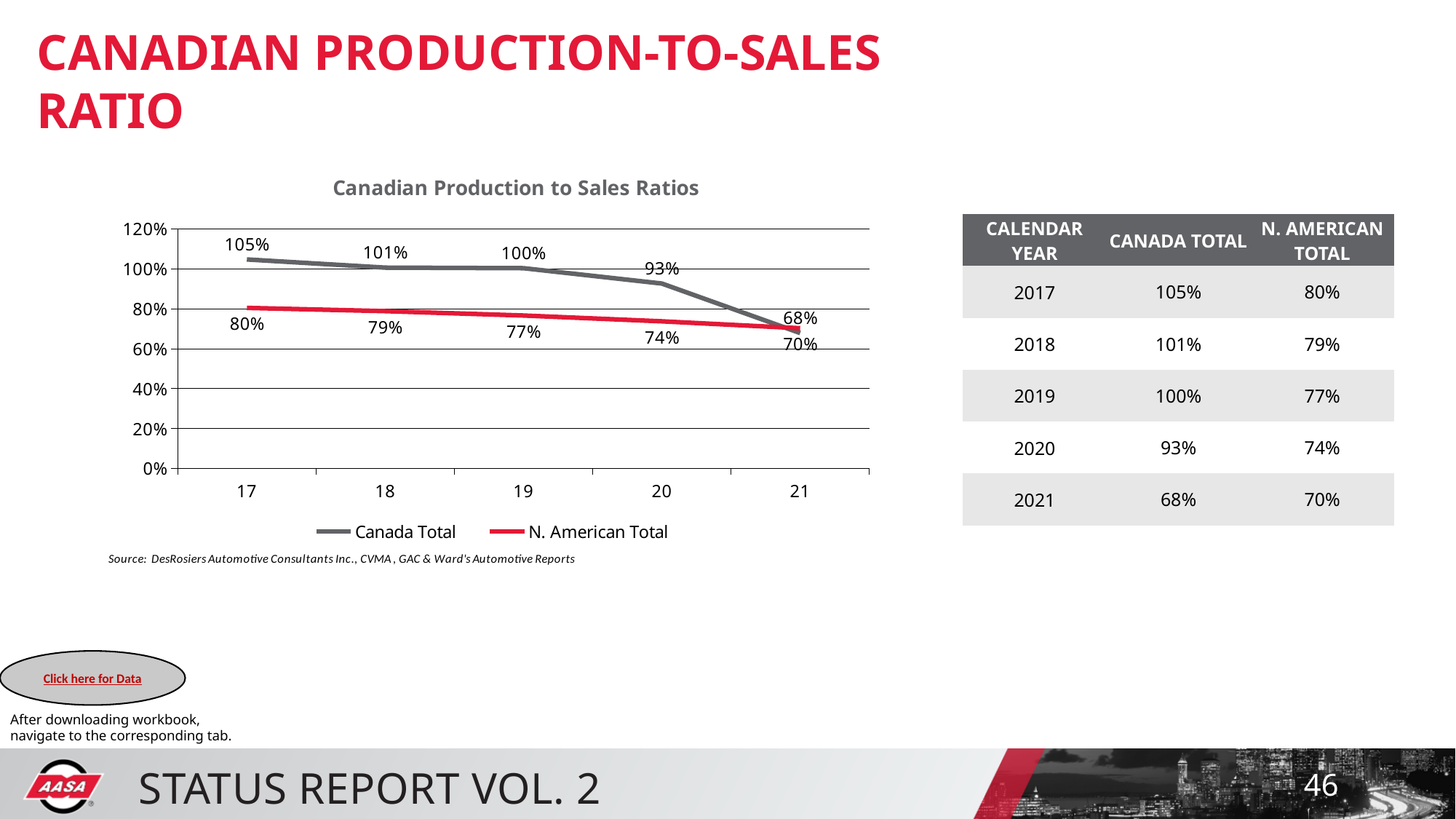
What is the difference between the Canada Total and N. American Total values in 2019? 23% What is the N. American Total value for 2020? 74% Does the Canada Total series rise or fall from 2017 to 2021? Fall What is the Canada Total value for 2021? 68% What kind of chart is shown? Line chart What is the Canada Total production-to-sales ratio for 2017? 105% In which year is the Canada Total ratio highest? 2017 How many series does the legend list? 2 What colour is the N. American Total line? Red How many years are plotted on the chart? 5 Which is larger in 2021, the Canada Total or the N. American Total? N. American Total In which year is the N. American Total ratio lowest? 2021